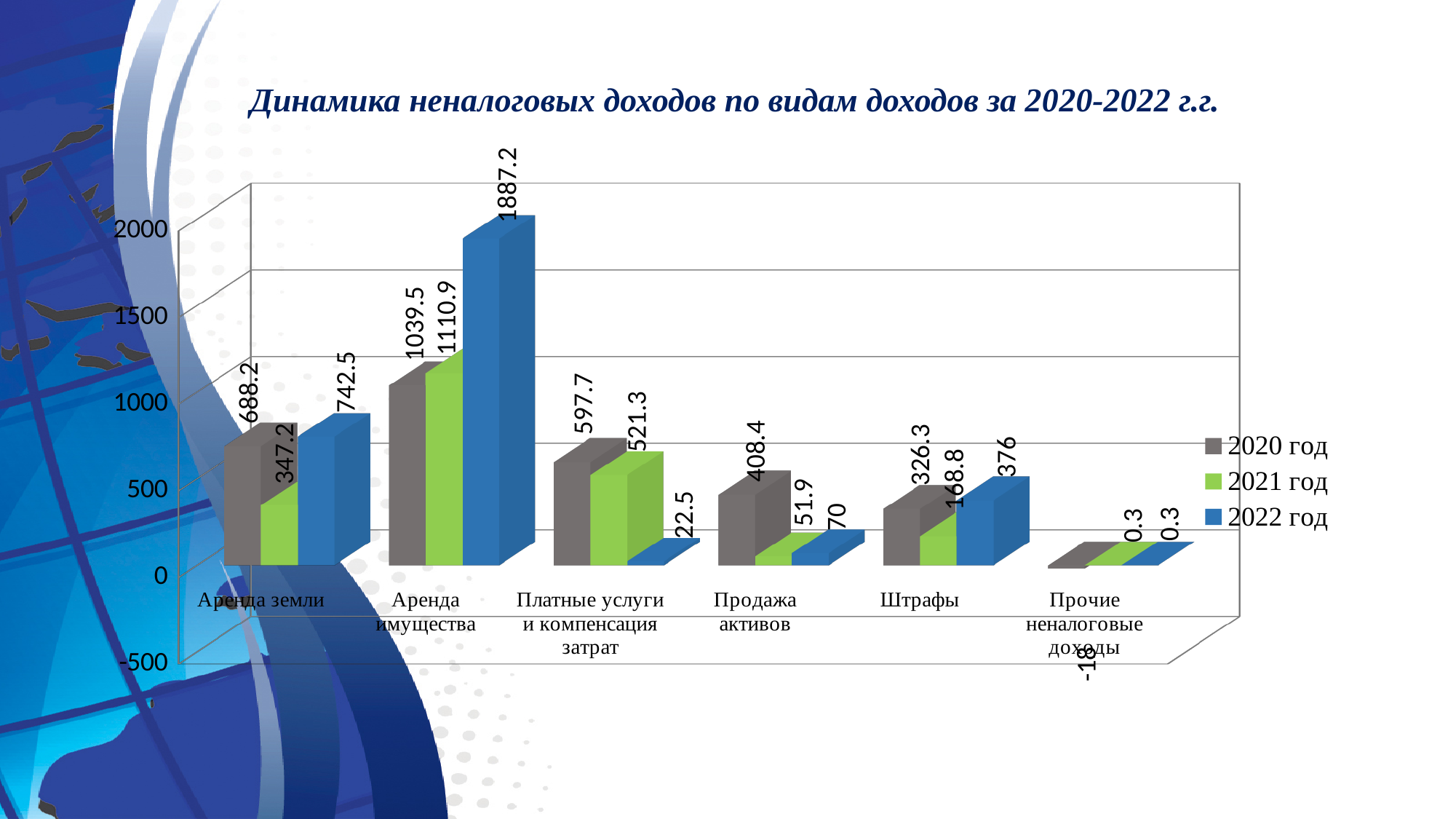
Which category has the highest value in the 2022 год series? Аренда имущества What is the difference between the 2022 год and 2020 год values for Аренда имущества? 847.7 How many series does the legend list? 3 Which category has the lowest value in the 2020 год series? Прочие неналоговые доходы What is the title of the chart? Динамика неналоговых доходов по видам доходов за 2020-2022 г.г. Which is larger for Продажа активов: the 2021 год value or the 2022 год value? 2022 год What is the value for Аренда имущества in the 2022 год series? 1887.2 What is the value for Платные услуги и компенсация затрат in the 2022 год series? 22.5 How many categories are shown on the x axis? 6 What is the value for Аренда земли in the 2021 год series? 347.2 What kind of chart is shown on the slide? Bar chart What is the value for Штрафы in the 2020 год series? 326.3